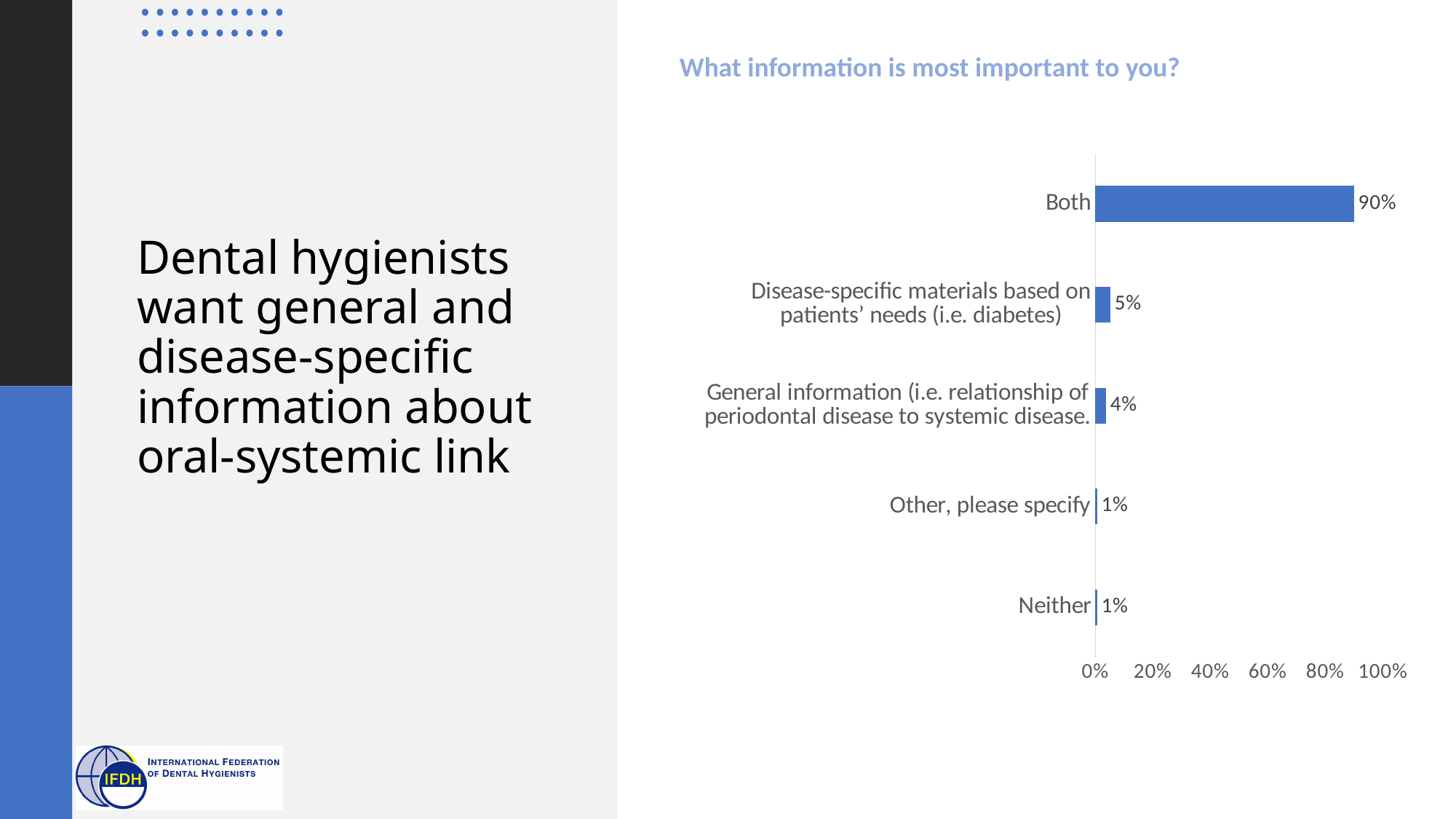
What is the value for "General information (i.e. relationship of periodontal disease to systemic disease."? 4% What kind of chart is shown on the slide? Bar chart Is the value for "Both" greater or less than 80%? greater Which is larger: the value for "Disease-specific materials based on patients' needs (i.e. diabetes)" or the value for "General information (i.e. relationship of periodontal disease to systemic disease."? Disease-specific materials based on patients' needs (i.e. diabetes) What is the value for "Disease-specific materials based on patients' needs (i.e. diabetes)"? 5% How many categories are shown in the chart? 5 What is the title of the chart? What information is most important to you? What is the difference between the value for "General information (i.e. relationship of periodontal disease to systemic disease." and the value for "Neither"? 3% What is the difference between the value for "Both" and the value for "Disease-specific materials based on patients' needs (i.e. diabetes)"? 85% What percentage of respondents chose "Both"? 90% What percentage chose "Other, please specify"? 1% Which category has the highest value? Both